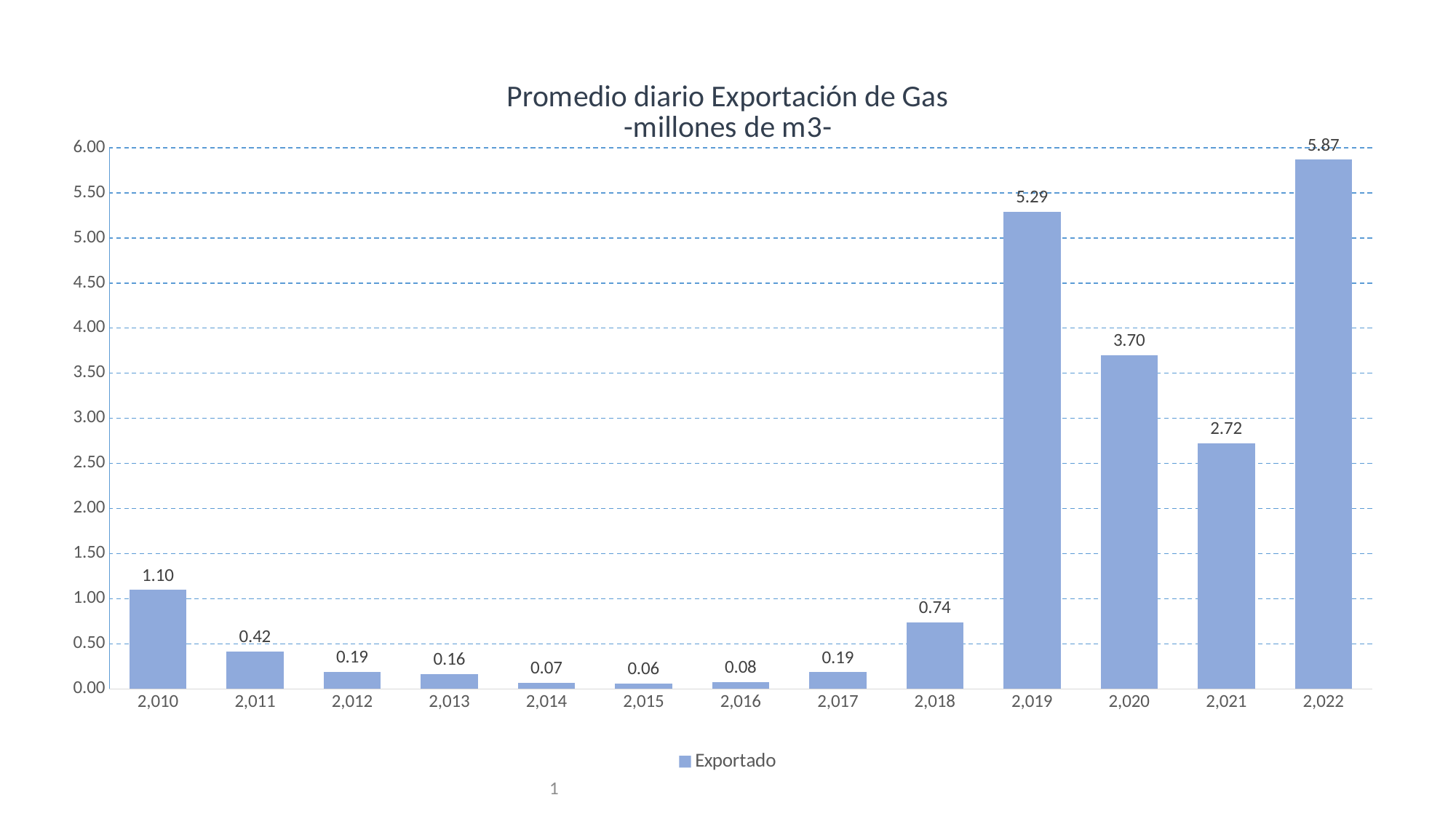
What is the difference between the values for 2,020 and 2,021? 0.98 What is the value for 2,021? 2.72 Which is larger, the value for 2,010 or the value for 2,018? 2,010 What is the difference between the values for 2,022 and 2,019? 0.58 What is the name of the series shown in the legend? Exportado How many years are shown on the x axis? 13 Which year has the highest value? 2,022 What is the value for 2,015? 0.06 Which year has the lowest value? 2,015 Is the value for 2,020 greater or less than 3.50? greater What is the value for 2,019? 5.29 What kind of chart is this? bar chart